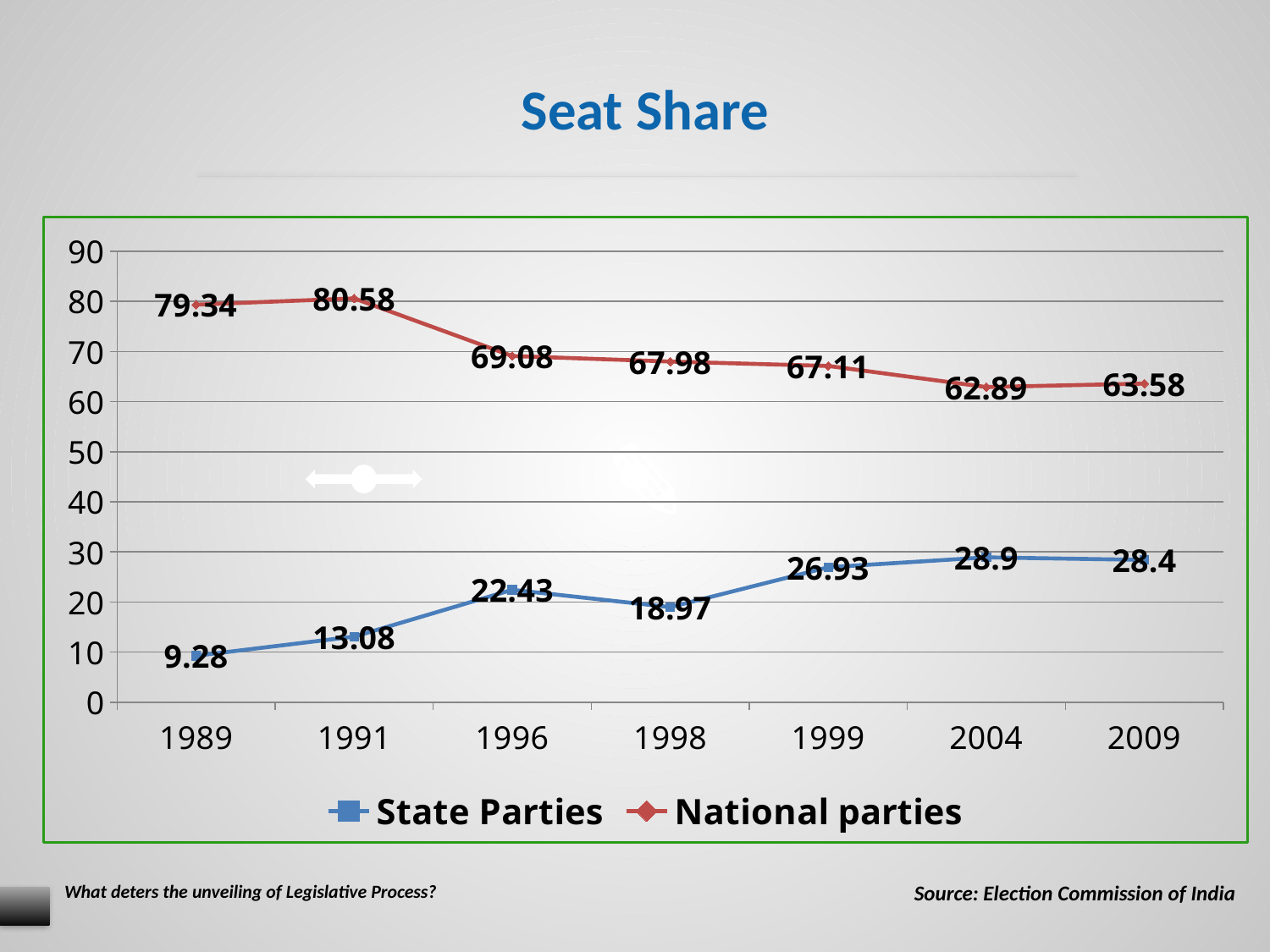
What is the seat share of National parties in 1991? 80.58 What is the seat share of State Parties in 2009? 28.4 How many years are shown on the x axis? 7 Does the seat share of National parties generally rise or fall from 1991 to 2004? Fall What is the seat share of State Parties in 1998? 18.97 What is the difference between the National parties and State Parties seat share in 1989? 70.06 What kind of chart is shown on the slide? Line chart In which year is the seat share of State Parties highest? 2004 In which year is the seat share of National parties lowest? 2004 How many series does the legend list? 2 What is the title of the chart? Seat Share Which series has the larger seat share in 1996, State Parties or National parties? National parties